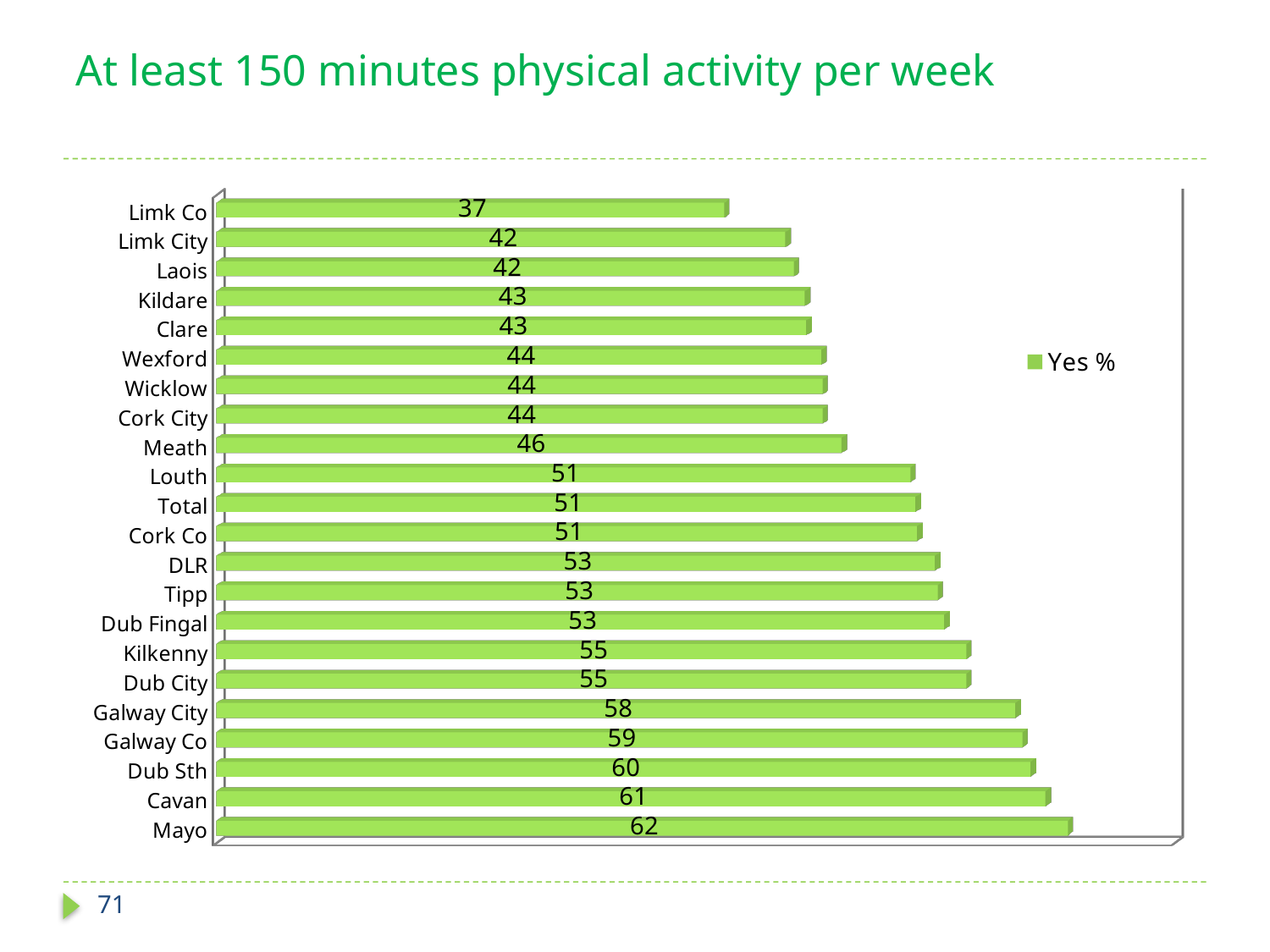
What series name is listed in the chart legend? Yes % What is the Yes % value for Galway City? 58 How many categories are shown in the chart? 22 What type of chart is shown on the slide? Bar chart Which has a larger Yes % value, Dub Sth or Kilkenny? Dub Sth What is the Yes % value for Total? 51 What is the Yes % value for Mayo? 62 What is the difference between the Yes % values for Mayo and Limk Co? 25 What is the Yes % value for Limk Co? 37 What is the difference between the Yes % values for Cavan and Meath? 15 Which category has the highest Yes % value? Mayo Which category has the lowest Yes % value? Limk Co